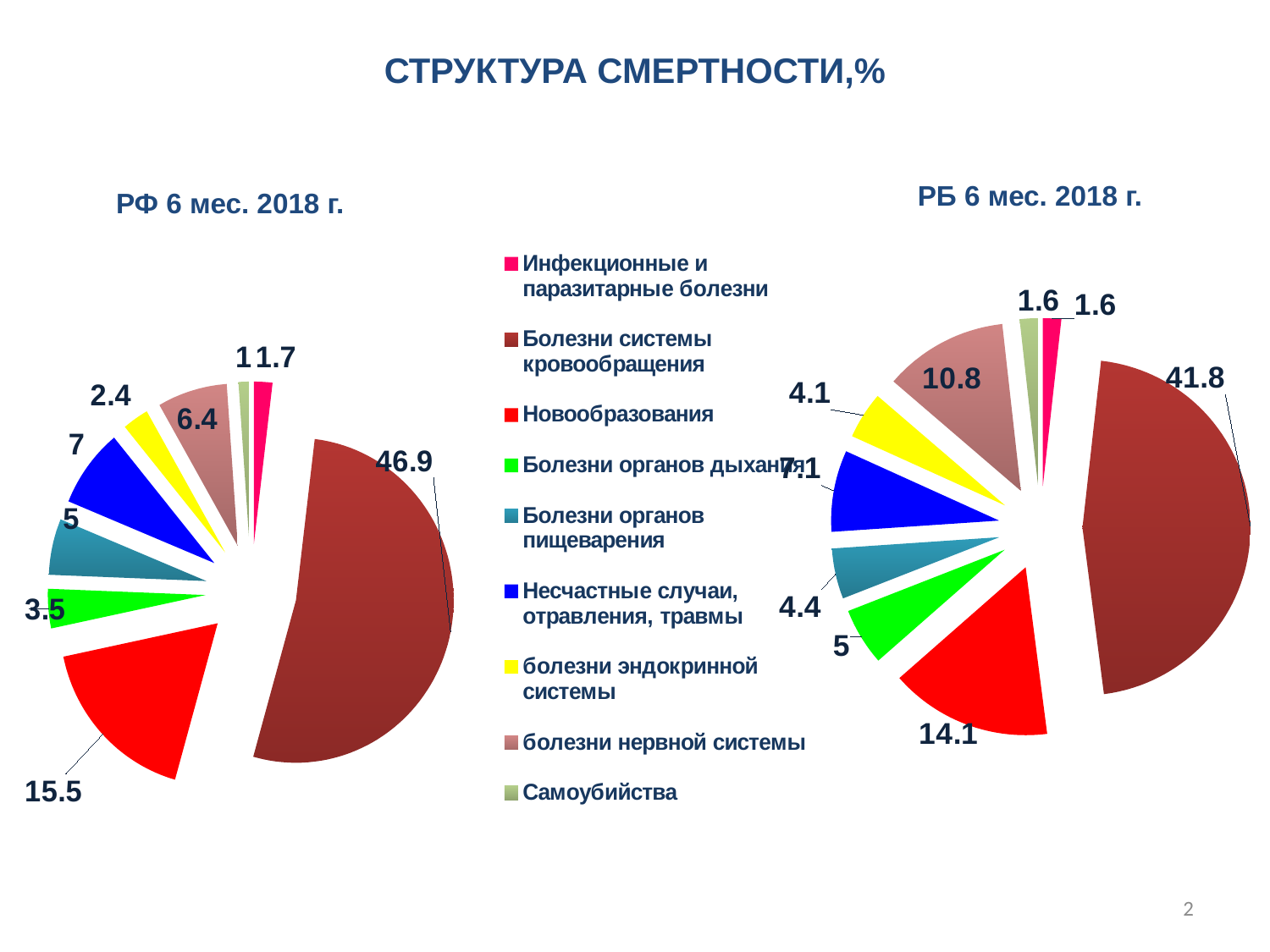
In the РБ 6 мес. 2018 г. chart, what is the value for Новообразования? 14.1 What type of chart is used on this slide? Pie chart In the РФ 6 мес. 2018 г. chart, what is the value for Болезни системы кровообращения? 46.9 In the РФ 6 мес. 2018 г. chart, what is the value for Болезни органов дыхания? 3.5 In the РФ 6 мес. 2018 г. chart, which category has the largest share? Болезни системы кровообращения In the РБ 6 мес. 2018 г. chart, what is the value for болезни нервной системы? 10.8 How many categories does the legend list? 9 What is the difference between the Болезни системы кровообращения values in the РФ chart and the РБ chart? 5.1 What colour represents Болезни органов дыхания in the legend? Green In the РБ 6 мес. 2018 г. chart, which category has the largest share? Болезни системы кровообращения Which is larger: Новообразования in the РФ 6 мес. 2018 г. chart or in the РБ 6 мес. 2018 г. chart? РФ 6 мес. 2018 г. In the РФ 6 мес. 2018 г. chart, which category has the smallest share? Самоубийства